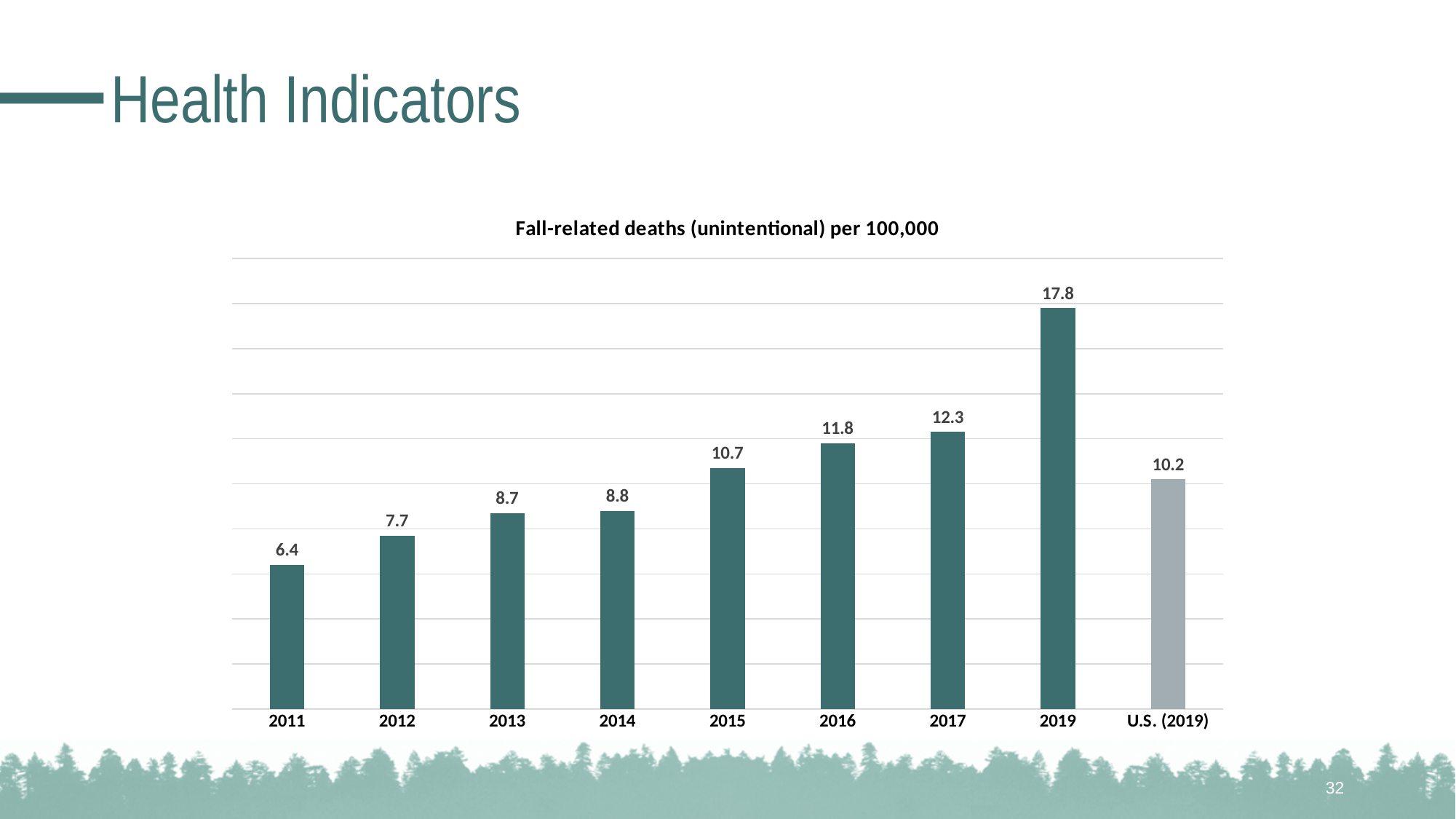
Which category has the highest value in the Fall-related deaths chart? 2019 How many bars are shown in the Fall-related deaths chart? 9 What is the difference between the 2017 value and the 2011 value? 5.9 What kind of chart is shown on the slide? Bar chart Which is larger, the value for 2016 or the value for U.S. (2019)? 2016 What is the value for 2011 in the Fall-related deaths chart? 6.4 Which category has the lowest value in the Fall-related deaths chart? 2011 What is the value for 2015 in the Fall-related deaths chart? 10.7 What is the difference between the 2019 value and the U.S. (2019) value? 7.6 What is the value for U.S. (2019) in the Fall-related deaths chart? 10.2 Do the values generally rise or fall from 2011 to 2019? Rise What is the title of the chart? Fall-related deaths (unintentional) per 100,000